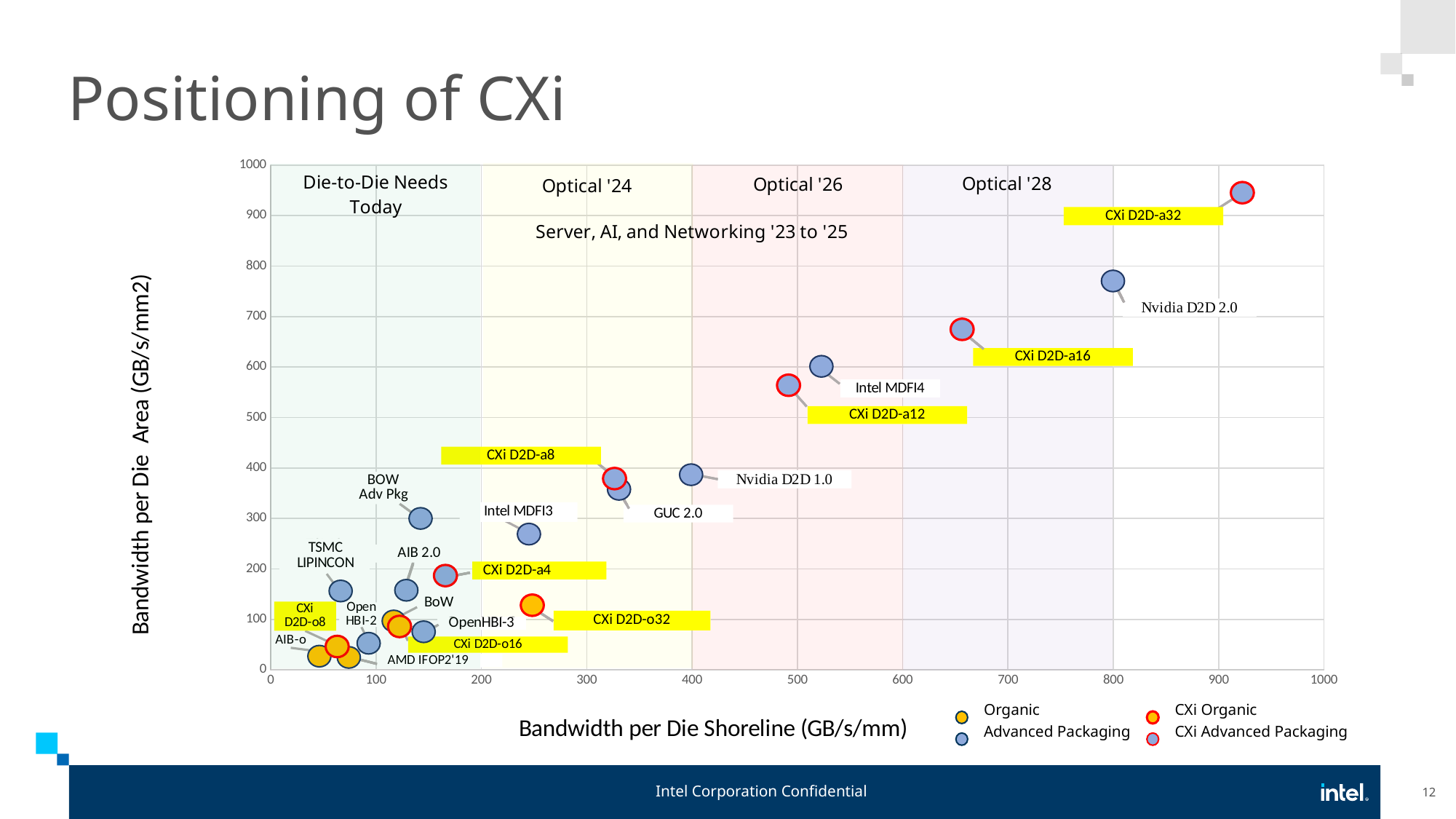
Is the Bandwidth per Die Shoreline for Nvidia D2D 1.0 greater or less than 300? greater Is the Bandwidth per Die Area for CXi D2D-a32 greater or less than 900? greater Which has the higher Bandwidth per Die Area, BOW Adv Pkg or AIB 2.0? BOW Adv Pkg Which point has the highest Bandwidth per Die Area? CXi D2D-a32 How many series does the legend list? 4 What is the title of the y axis? Bandwidth per Die Area (GB/s/mm2) What is the title of the x axis? Bandwidth per Die Shoreline (GB/s/mm) Is the Bandwidth per Die Area for Nvidia D2D 2.0 greater or less than 700? greater Which has the higher Bandwidth per Die Area, Nvidia D2D 2.0 or CXi D2D-a16? Nvidia D2D 2.0 What kind of chart is shown on the slide? scatter chart Which has the higher Bandwidth per Die Area, Intel MDFI4 or CXi D2D-a12? Intel MDFI4